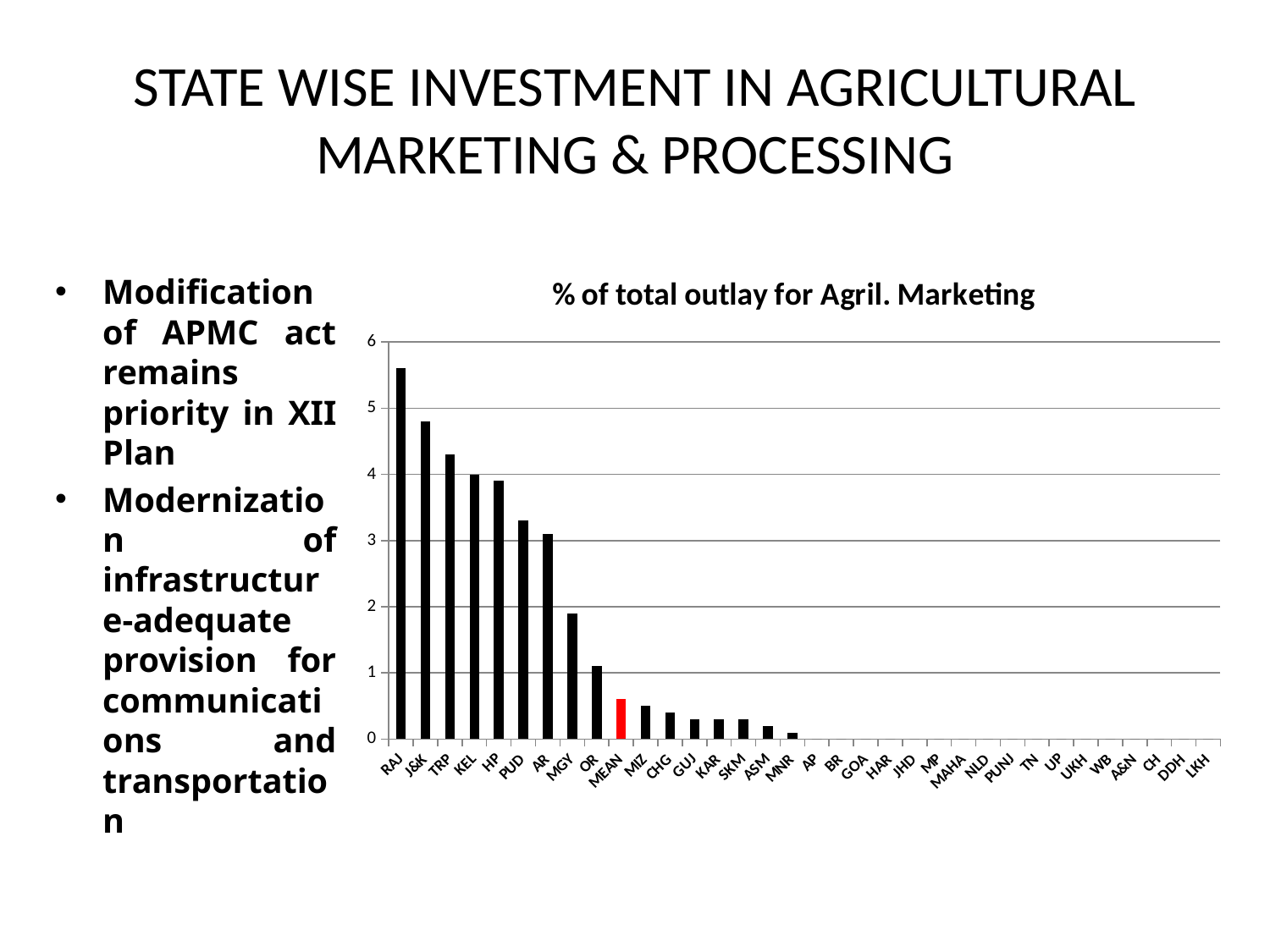
What kind of chart is shown on the slide? bar chart Which is larger, the value for RAJ or the value for J&K? RAJ Do the values rise or fall moving from left to right along the x axis? fall Which category has the highest value? RAJ Is the value for MEAN greater or less than 1? less How many categories are shown on the x axis? 34 What is the title of the chart? % of total outlay for Agril. Marketing Is the value for TRP greater or less than 4? greater Is the value for RAJ greater or less than 5? greater Which category is shown with a red bar? MEAN